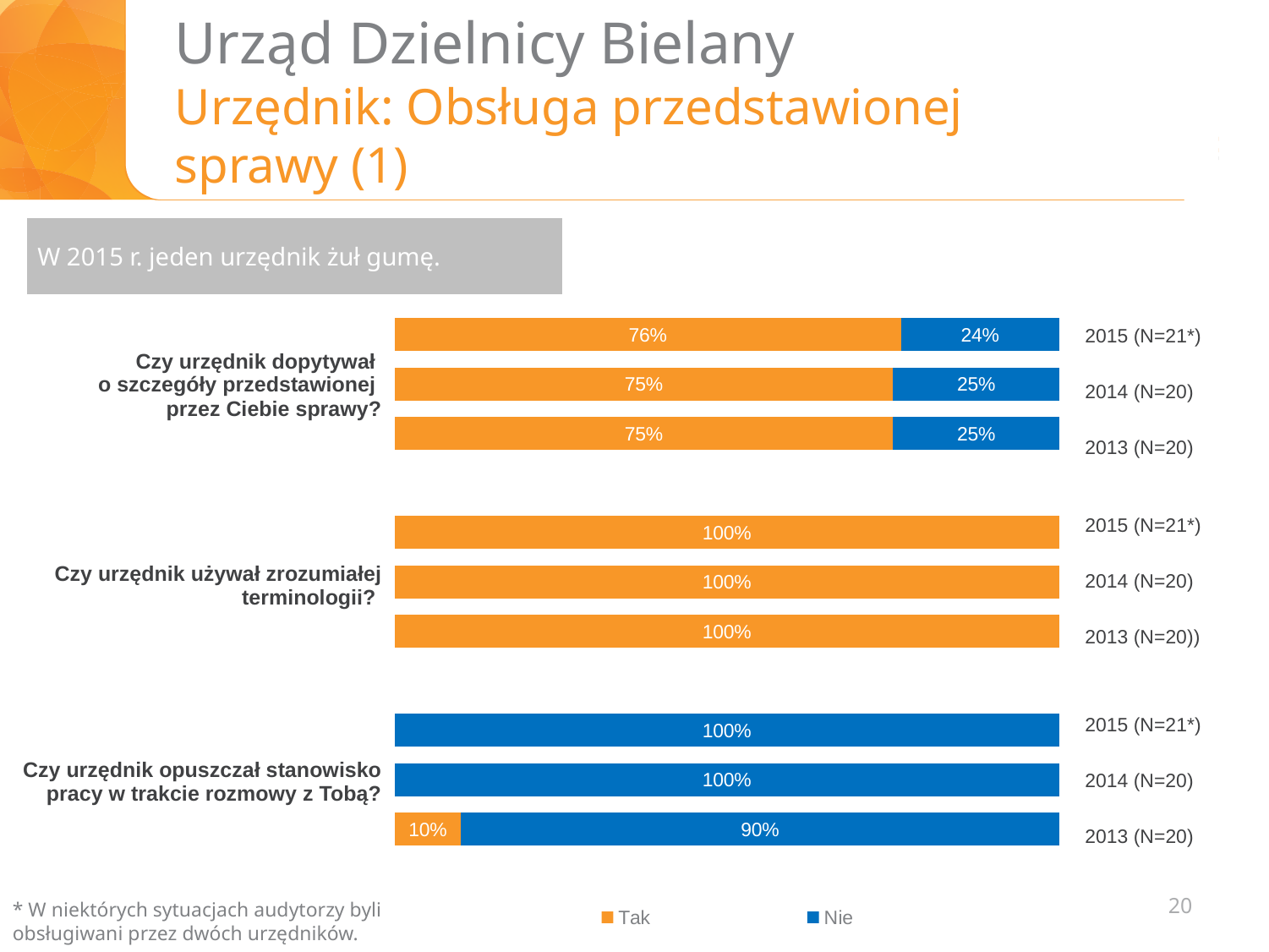
For the question "Czy urzędnik dopytywał o szczegóły przedstawionej przez Ciebie sprawy?", what is the difference between the Tak value in 2015 and the Tak value in 2014? 1% For the question "Czy urzędnik opuszczał stanowisko pracy w trakcie rozmowy z Tobą?", what is the Tak value in 2013 (N=20)? 10% How many series does the legend list? 2 What kind of chart is shown on the slide? bar chart For the question "Czy urzędnik używał zrozumiałej terminologii?", what is the Tak value in 2013 (N=20)? 100% For the question "Czy urzędnik dopytywał o szczegóły przedstawionej przez Ciebie sprawy?", which is larger in 2015: the Tak value or the Nie value? Tak For the question "Czy urzędnik opuszczał stanowisko pracy w trakcie rozmowy z Tobą?", what is the Nie value in 2013 (N=20)? 90% For the question "Czy urzędnik dopytywał o szczegóły przedstawionej przez Ciebie sprawy?", what is the Tak value in 2015 (N=21*)? 76% How many bars are plotted on the chart in total? 9 For the question "Czy urzędnik opuszczał stanowisko pracy w trakcie rozmowy z Tobą?", what is the total of the stacked bar for 2013 (N=20)? 100% What are the two series named in the legend? Tak and Nie For the question "Czy urzędnik dopytywał o szczegóły przedstawionej przez Ciebie sprawy?", what is the Nie value in 2014 (N=20)? 25%